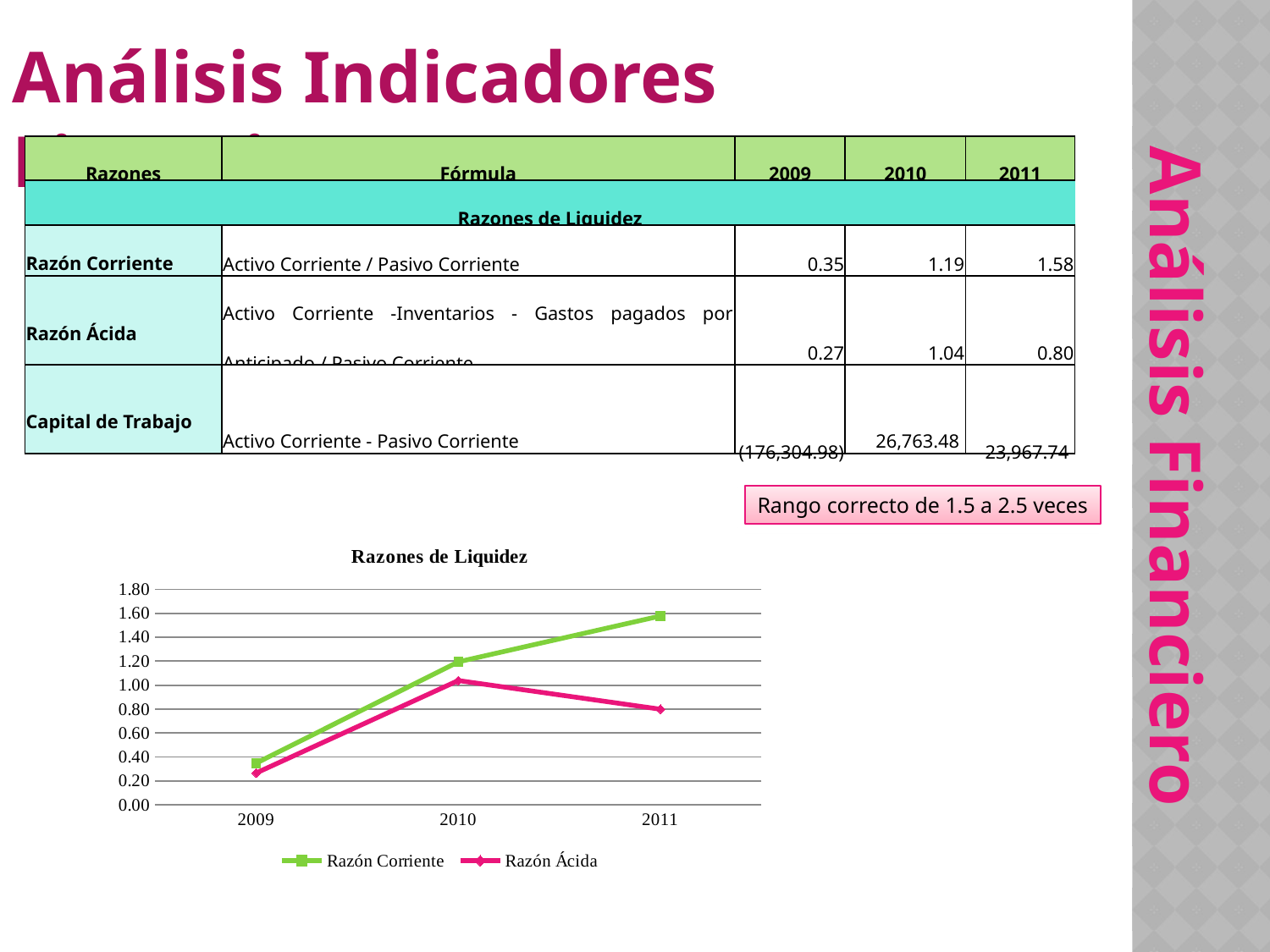
In which year is Razón Corriente highest? 2011 Is the value of Razón Corriente in 2011 greater or less than 1.40? greater What type of chart is "Razones de Liquidez"? line chart What is the value of Razón Ácida in 2010? 1.04 Does Razón Corriente rise or fall from 2009 to 2011? rise How many years are plotted on the x axis of the "Razones de Liquidez" chart? 3 What is the value of Razón Corriente in 2011? 1.58 Is the value of Razón Ácida in 2011 greater or less than 1.00? less What is the difference between Razón Corriente and Razón Ácida in 2011? 0.78 Which series has the larger value in 2011, Razón Corriente or Razón Ácida? Razón Corriente In which year is Razón Ácida lowest? 2009 How many series does the legend of the "Razones de Liquidez" chart list? 2